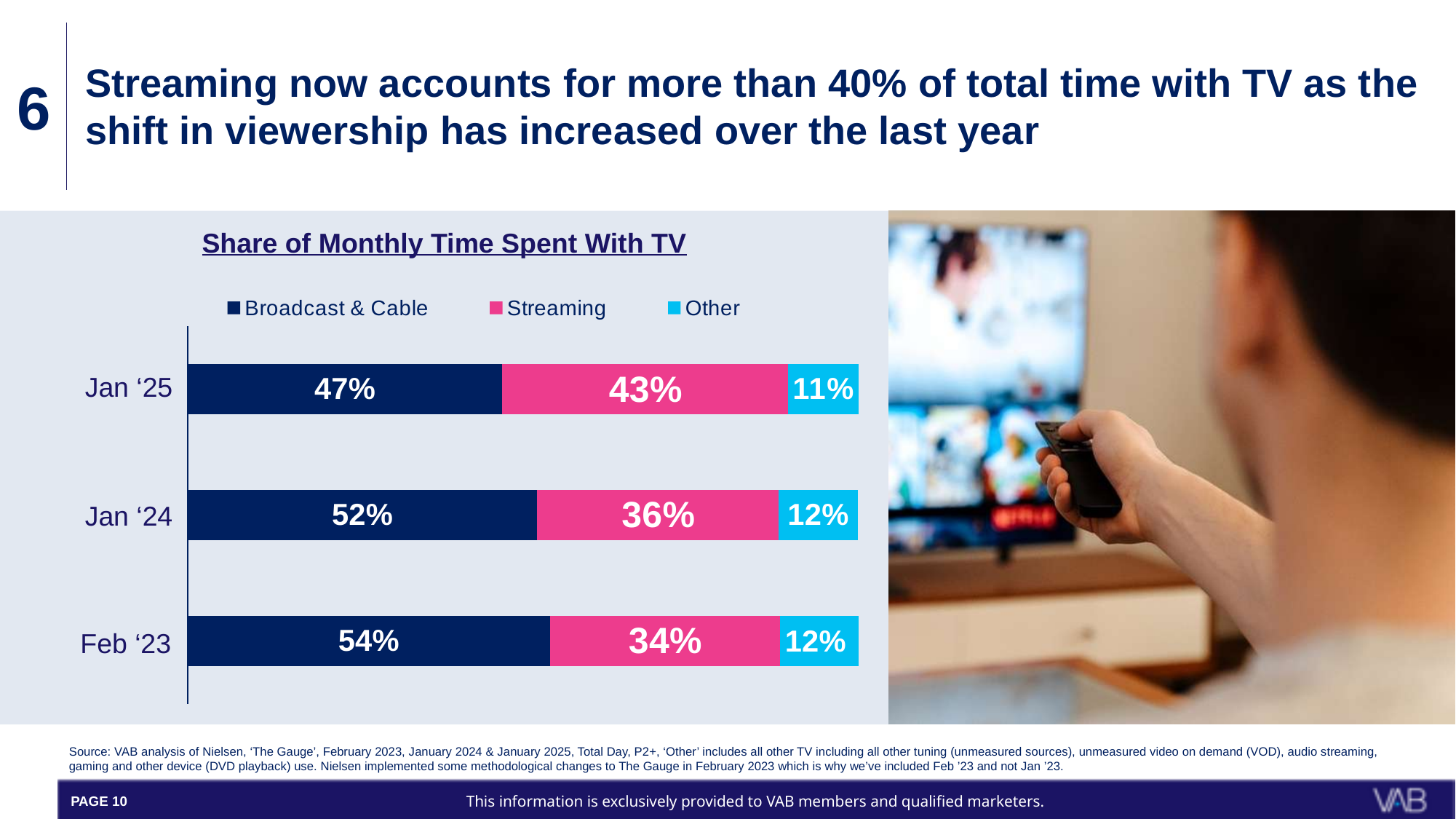
What kind of chart is shown on the slide? Stacked bar chart Which period has the highest Streaming share? Jan '25 How many series does the legend list? 3 What is the Other share for Jan '24? 12% Which is larger in Jan '24: the Broadcast & Cable share or the Streaming share? Broadcast & Cable What is the title of the chart? Share of Monthly Time Spent With TV Which period has the lowest Broadcast & Cable share? Jan '25 Does the Streaming share rise or fall from Feb '23 to Jan '25? Rise What is the Streaming share for Jan '25? 43% What is the Broadcast & Cable share for Feb '23? 54% What is the difference between the Broadcast & Cable share in Feb '23 and in Jan '25? 7% How many time periods are shown on the chart? 3